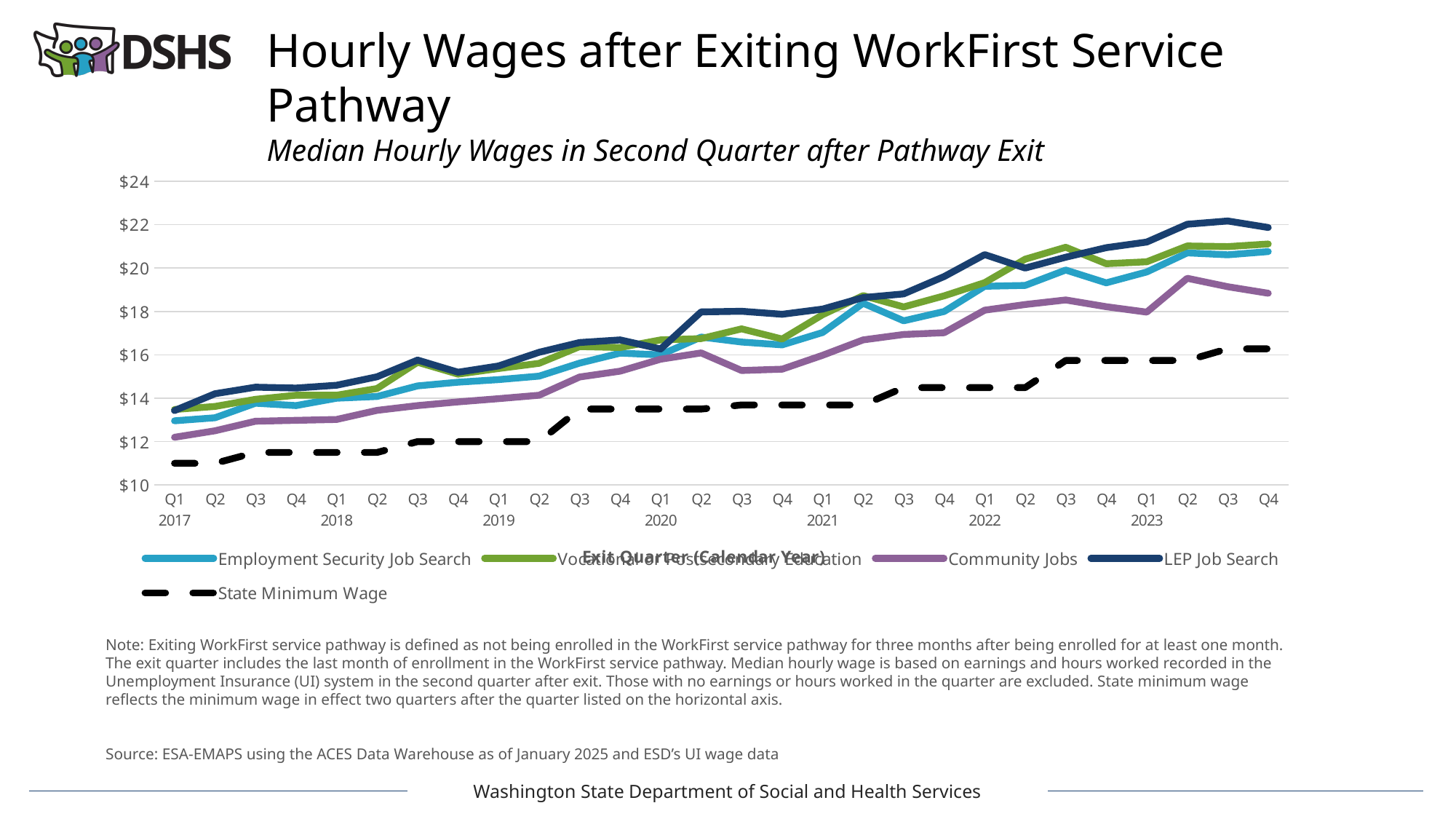
What kind of chart is shown on the slide? line chart In Q1 2017, which is higher: Employment Security Job Search or Community Jobs? Employment Security Job Search Is the LEP Job Search value in Q4 2023 greater or less than $20? greater Is the Community Jobs value in Q1 2017 greater or less than $14? less How many quarters are shown along the x axis? 28 Which series is drawn as a dashed line? State Minimum Wage Which series has the highest value in Q4 2023? LEP Job Search How many series does the legend list? 5 Which series has the lowest value in Q4 2023? State Minimum Wage Does the LEP Job Search line generally rise or fall from Q1 2017 to Q4 2023? rise In Q4 2023, which is higher: Community Jobs or LEP Job Search? LEP Job Search Is the State Minimum Wage value in Q1 2017 greater or less than $12? less